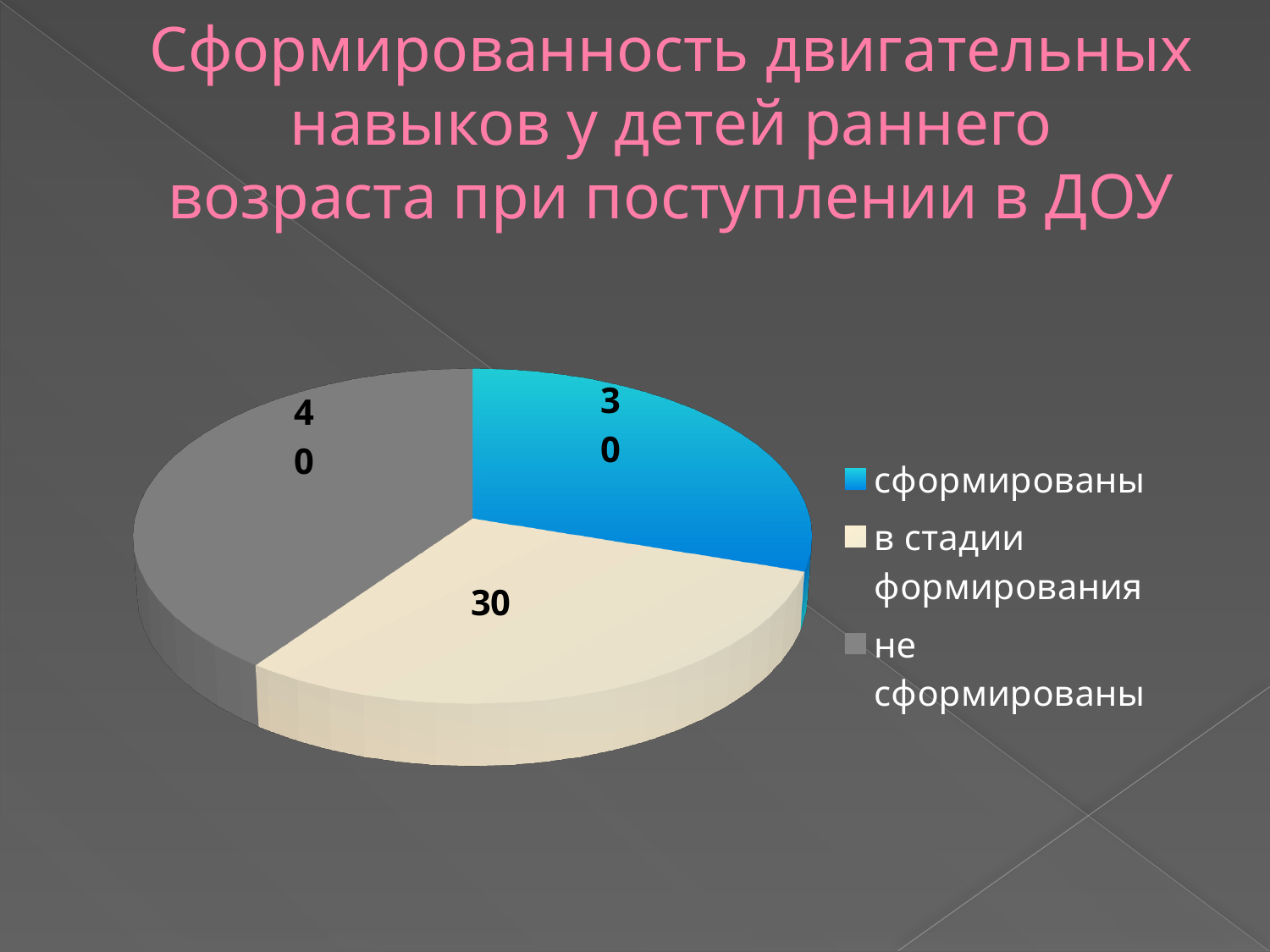
How many entries does the legend list? 3 What is the total of all the slice values in the pie chart? 100 What kind of chart is shown on the slide? pie chart What is the value for the slice "в стадии формирования"? 30 What is the value for the slice "сформированы"? 30 What is the value for the slice "не сформированы"? 40 What share of the pie does the slice "не сформированы" represent? 40% Which is larger: the value for "не сформированы" or the value for "сформированы"? не сформированы What colour is the slice for "сформированы"? blue What is the difference between the value for "не сформированы" and the value for "в стадии формирования"? 10 How many slices does the pie chart have? 3 Which slice of the pie has the highest value? не сформированы